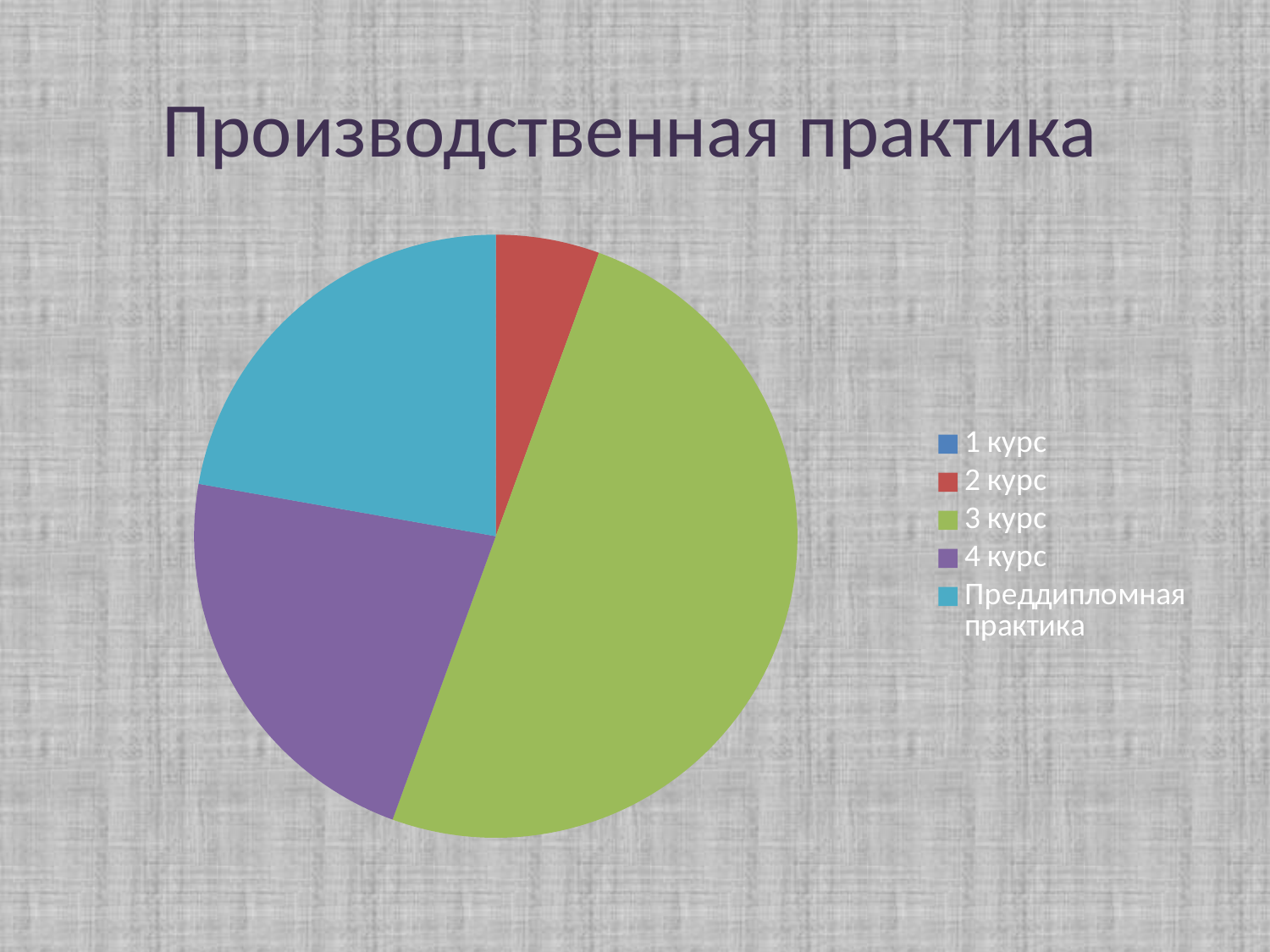
Which is larger, the slice for 2 курс or the slice for Преддипломная практика? Преддипломная практика How many data series does the pie chart show? 1 What is the title of the chart on the slide? Производственная практика What colour is the slice for 3 курс in the pie chart? green Which is larger, the slice for 3 курс or the slice for 4 курс? 3 курс Which category has the largest slice of the pie? 3 курс Which legend entry is listed last in the pie chart's legend? Преддипломная практика Which is larger, the slice for 3 курс or the slice for 2 курс? 3 курс How many categories does the legend of the pie chart list? 5 What kind of chart is shown on the slide? pie chart